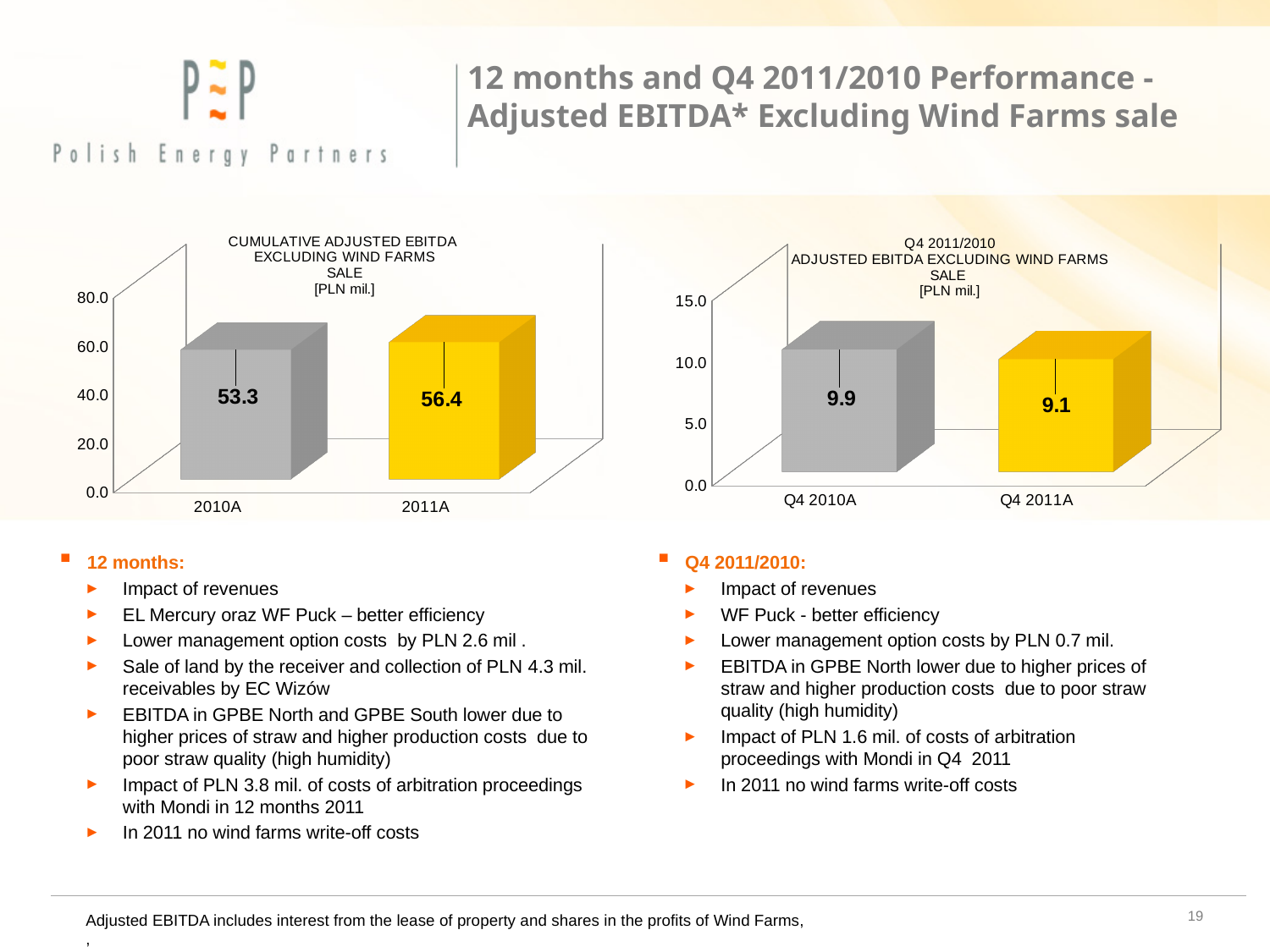
What unit is stated in the title of the left chart? PLN mil. In the left chart, what is the difference between the 2011A and 2010A values? 3.1 How many bars are shown in the left chart? 2 In the left chart (Cumulative Adjusted EBITDA Excluding Wind Farms Sale), what is the value for 2011A? 56.4 In the right chart, what is the difference between the Q4 2010A and Q4 2011A values? 0.8 In the left chart, which year has the higher cumulative adjusted EBITDA? 2011A In the right chart, which quarter has the lower adjusted EBITDA? Q4 2011A In the right chart (Q4 2011/2010 Adjusted EBITDA Excluding Wind Farms Sale), what is the value for Q4 2011A? 9.1 In the left chart (Cumulative Adjusted EBITDA Excluding Wind Farms Sale), what is the value for 2010A? 53.3 In the right chart (Q4 2011/2010 Adjusted EBITDA Excluding Wind Farms Sale), what is the value for Q4 2010A? 9.9 In the right chart, is the value for Q4 2010A greater or less than 5.0? greater What type of chart is the right chart? Bar chart